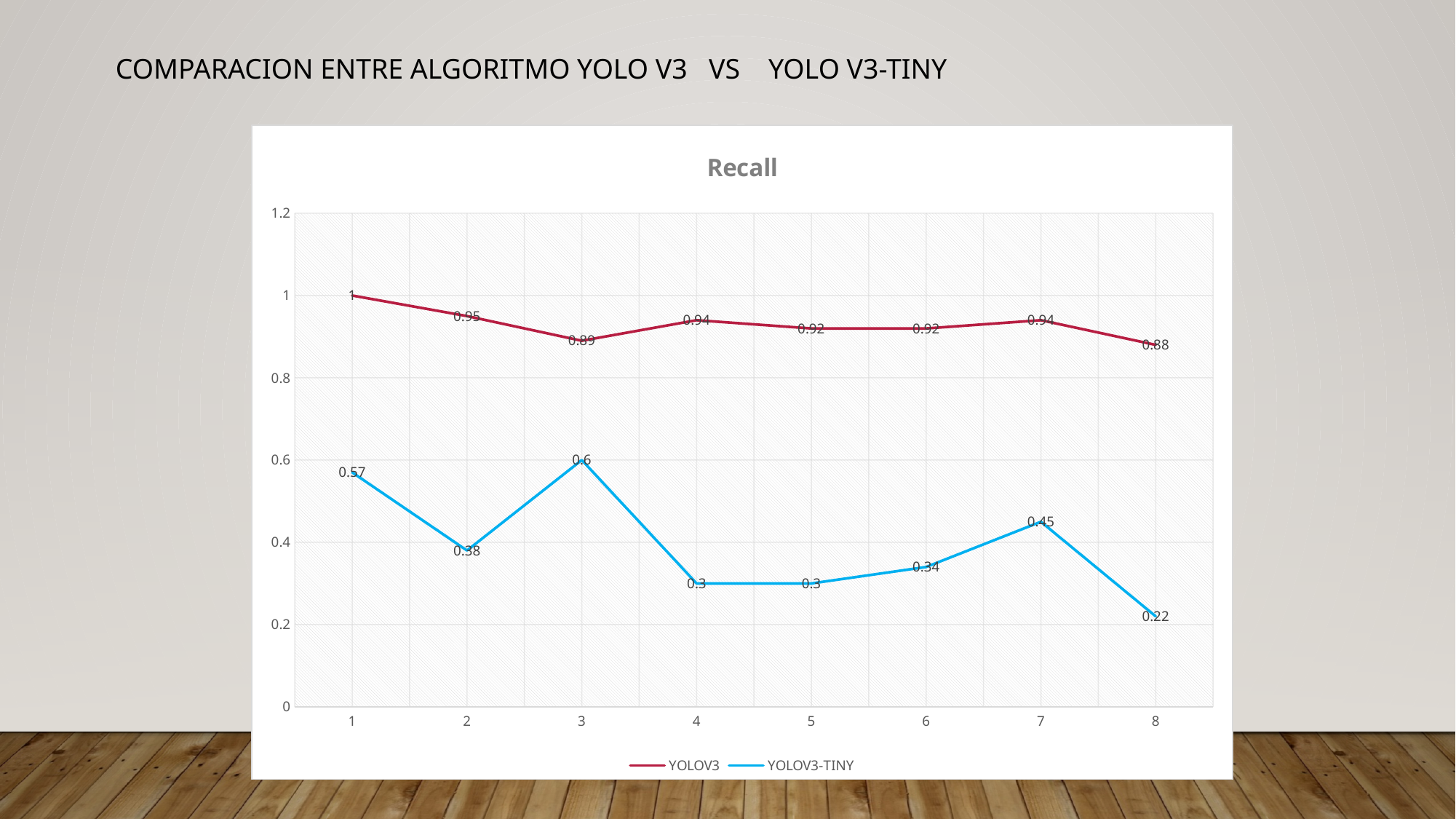
What is the difference between the YOLOV3 and YOLOV3-TINY Recall values at point 4? 0.64 At which point does YOLOV3-TINY reach its lowest Recall value? 8 What is the title of the chart? Recall What is the Recall value for YOLOV3-TINY at point 8? 0.22 Which series has the higher Recall value at point 2, YOLOV3 or YOLOV3-TINY? YOLOV3 What is the Recall value for YOLOV3-TINY at point 3? 0.6 What is the Recall value for YOLOV3 at point 1? 1 What is the Recall value for YOLOV3 at point 8? 0.88 At which point does YOLOV3 reach its highest Recall value? 1 What kind of chart is shown on the slide? Line chart How many series does the legend list? 2 How many points are plotted along the x axis for each series? 8